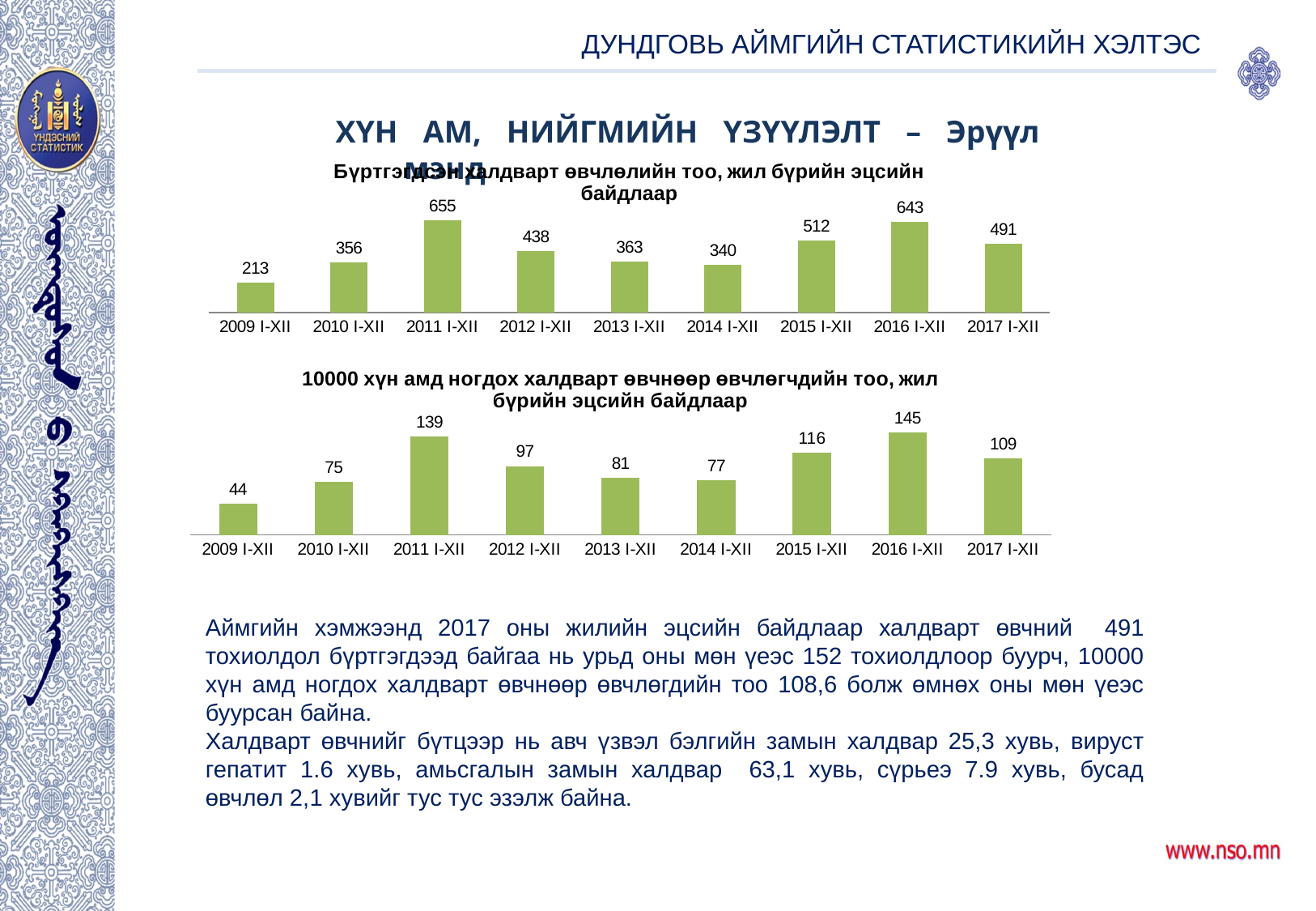
In the bottom chart (10000 хүн амд ногдох халдварт өвчнөөр өвчлөгчдийн тоо), which is larger: the value for 2010 I-XII or 2013 I-XII? 2013 I-XII In the bottom chart (10000 хүн амд ногдох халдварт өвчнөөр өвчлөгчдийн тоо), what is the value for 2017 I-XII? 109 In the top chart (Бүртгэгдсэн халдварт өвчлөлийн тоо), do the values rise or fall from 2009 I-XII to 2011 I-XII? Rise In the top chart (Бүртгэгдсэн халдварт өвчлөлийн тоо), which year has the lowest value? 2009 I-XII In the top chart (Бүртгэгдсэн халдварт өвчлөлийн тоо), which is larger: the value for 2012 I-XII or 2015 I-XII? 2015 I-XII In the top chart (Бүртгэгдсэн халдварт өвчлөлийн тоо), what is the difference between the values for 2016 I-XII and 2017 I-XII? 152 In the top chart (Бүртгэгдсэн халдварт өвчлөлийн тоо), what is the value for 2011 I-XII? 655 In the bottom chart (10000 хүн амд ногдох халдварт өвчнөөр өвчлөгчдийн тоо), what is the value for 2014 I-XII? 77 What type of chart is the bottom chart (10000 хүн амд ногдох халдварт өвчнөөр өвчлөгчдийн тоо)? Bar chart In the top chart (Бүртгэгдсэн халдварт өвчлөлийн тоо), how many years are plotted? 9 In the bottom chart (10000 хүн амд ногдох халдварт өвчнөөр өвчлөгчдийн тоо), what is the difference between the values for 2011 I-XII and 2009 I-XII? 95 In the bottom chart (10000 хүн амд ногдох халдварт өвчнөөр өвчлөгчдийн тоо), which year has the highest value? 2016 I-XII